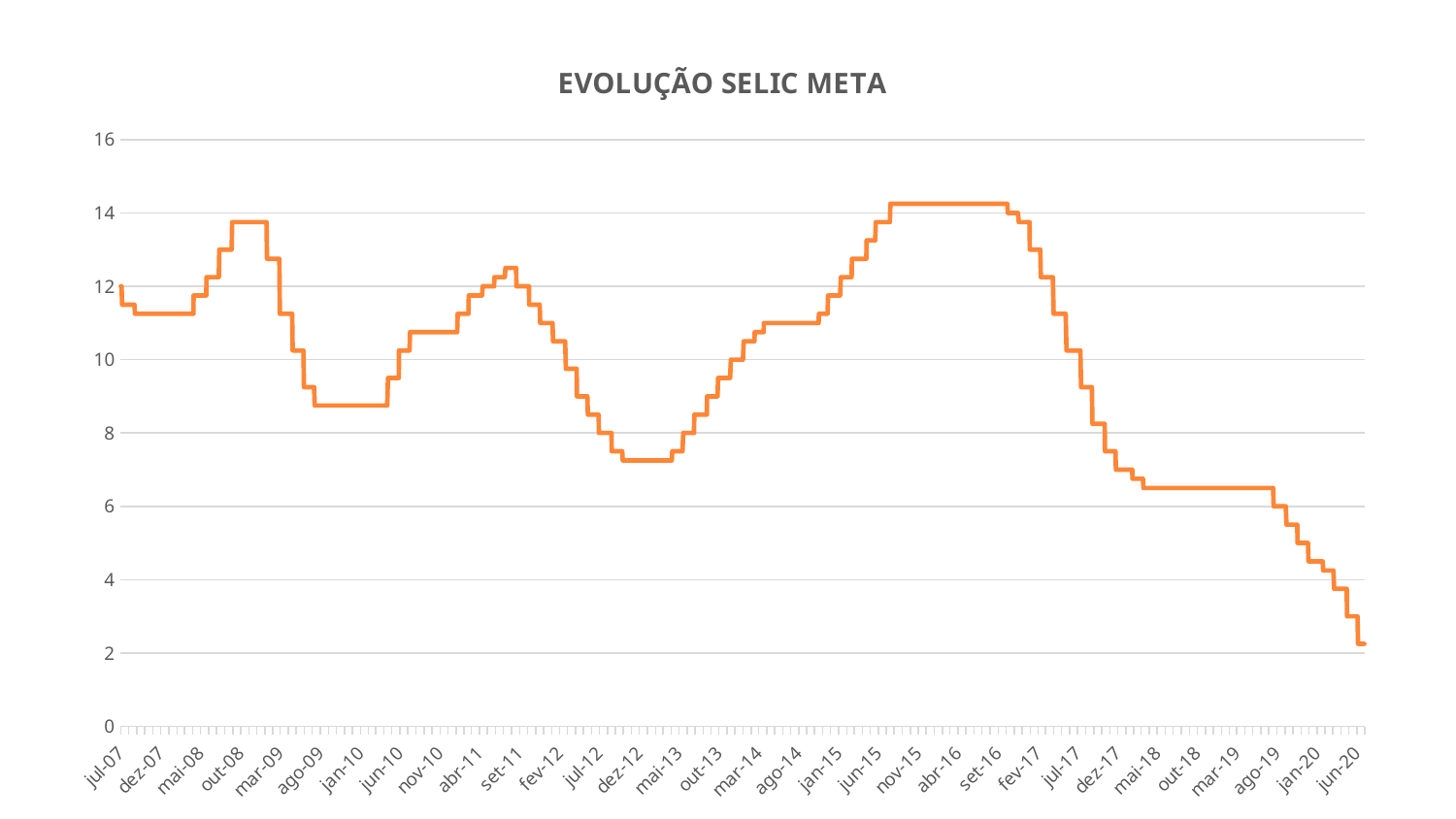
Is the value for out-08 greater or less than 12? greater What kind of chart is shown on the slide? Line chart Does the line rise or fall between set-16 and jun-20? Fall What is the title of the chart? EVOLUÇÃO SELIC META Which is larger, the value at out-08 or the value at jan-10? out-08 Is the value for nov-15 greater or less than 12? greater What colour is the line in the chart? Orange Is the value for jun-20 greater or less than 4? less At which x-axis label does the line reach its lowest value? jun-20